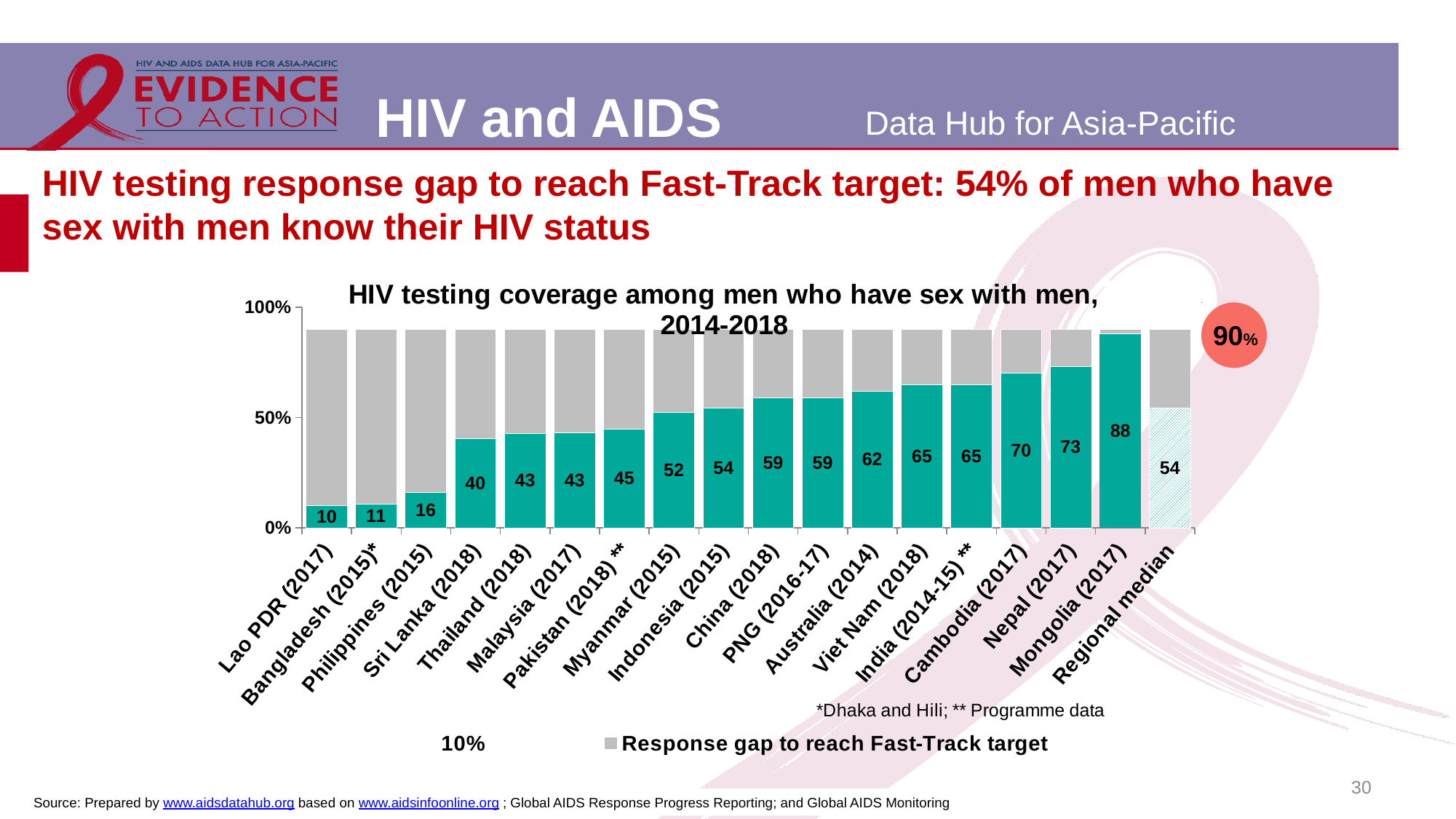
What is the HIV testing coverage value shown for Lao PDR (2017)? 10 Which country has the highest HIV testing coverage in the chart? Mongolia (2017) Which country has the lowest HIV testing coverage in the chart? Lao PDR (2017) What Fast-Track target percentage is shown in the red circle next to the chart? 90% What kind of chart is used on this slide? Stacked bar chart What is the HIV testing coverage value shown for Mongolia (2017)? 88 What value is shown for the Regional median bar? 54 What is the difference between the testing coverage values for Nepal (2017) and Cambodia (2017)? 3 Do the country testing coverage values rise or fall from left to right across the chart (before the Regional median)? Rise How many bars are shown in the chart, including the Regional median? 18 Which has a higher testing coverage value, Myanmar (2015) or Indonesia (2015)? Indonesia (2015) What is the difference between the testing coverage values for Mongolia (2017) and Lao PDR (2017)? 78